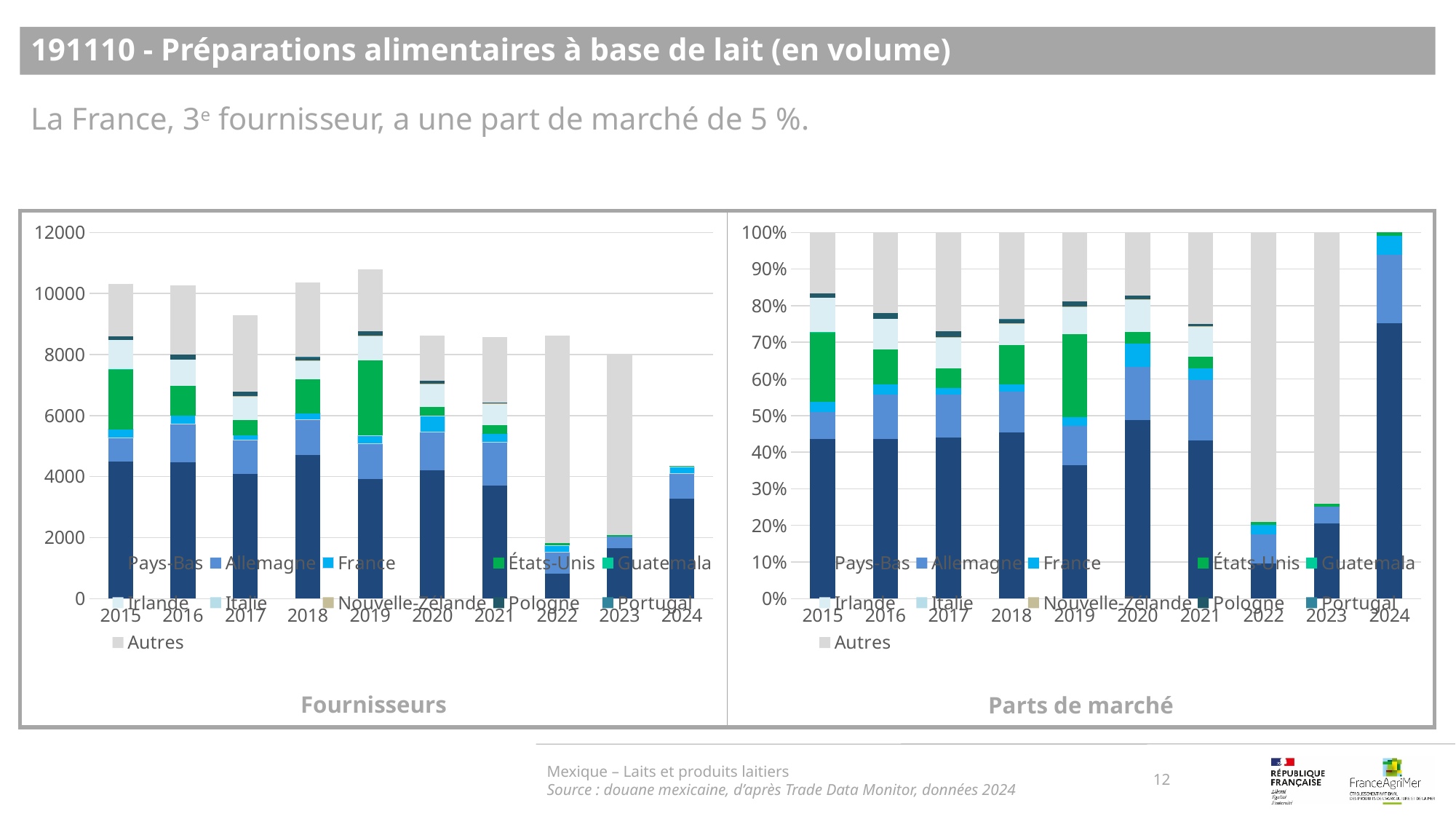
In the 'Fournisseurs' chart, which year has the larger total bar, 2015 or 2017? 2015 In the 'Fournisseurs' chart, which year has the highest total bar? 2019 In the 'Parts de marché' chart, is the share of Pays-Bas in 2024 greater or less than 70%? greater How many years are shown on the x axis of the 'Fournisseurs' chart? 10 In the 'Fournisseurs' chart, is the total for 2019 greater or less than 10000? greater In the 'Fournisseurs' chart, is the total for 2023 greater or less than 10000? less In the 'Fournisseurs' chart, do the total bars rise or fall from 2019 to 2023? fall What kind of chart is the 'Fournisseurs' chart on the left? stacked bar chart In the 'Fournisseurs' chart, which year has the lowest total bar? 2024 How many series does the legend of the 'Parts de marché' chart list? 11